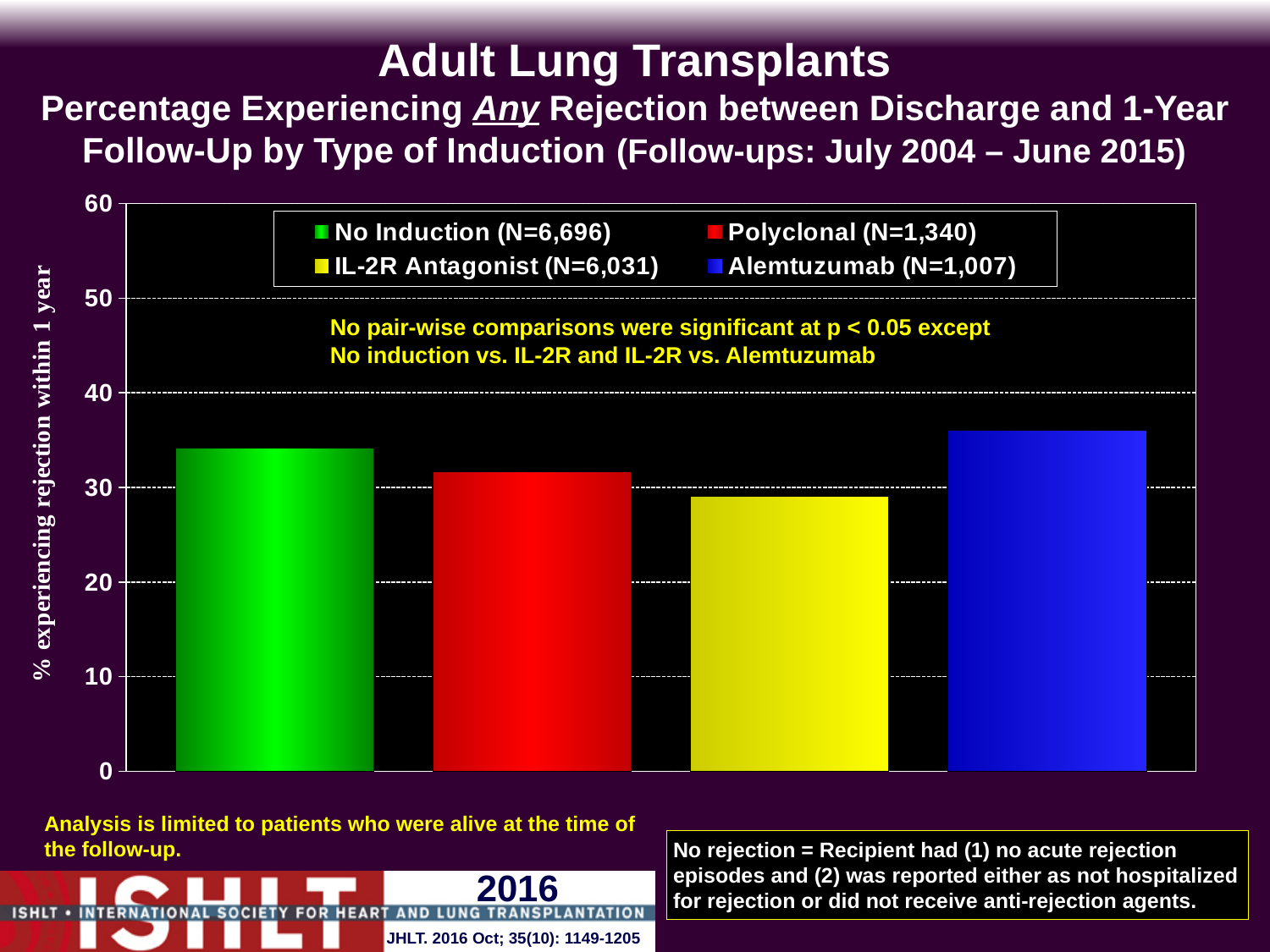
How many bars are plotted in the chart? 4 According to the legend, what is the N for the IL-2R Antagonist group? 6,031 Which is larger, the value for No Induction or the value for IL-2R Antagonist? No Induction What colour is the bar for Polyclonal induction? red Which induction type has the lowest percentage experiencing rejection within 1 year? IL-2R Antagonist What kind of chart is shown on the slide? bar chart Is the value for Alemtuzumab greater or less than 40? less Is the value for No Induction greater or less than 30? greater Is the value for IL-2R Antagonist greater or less than 20? greater Which induction type has the highest percentage experiencing rejection within 1 year? Alemtuzumab Which is larger, the value for Alemtuzumab or the value for Polyclonal? Alemtuzumab How many series does the legend list? 4